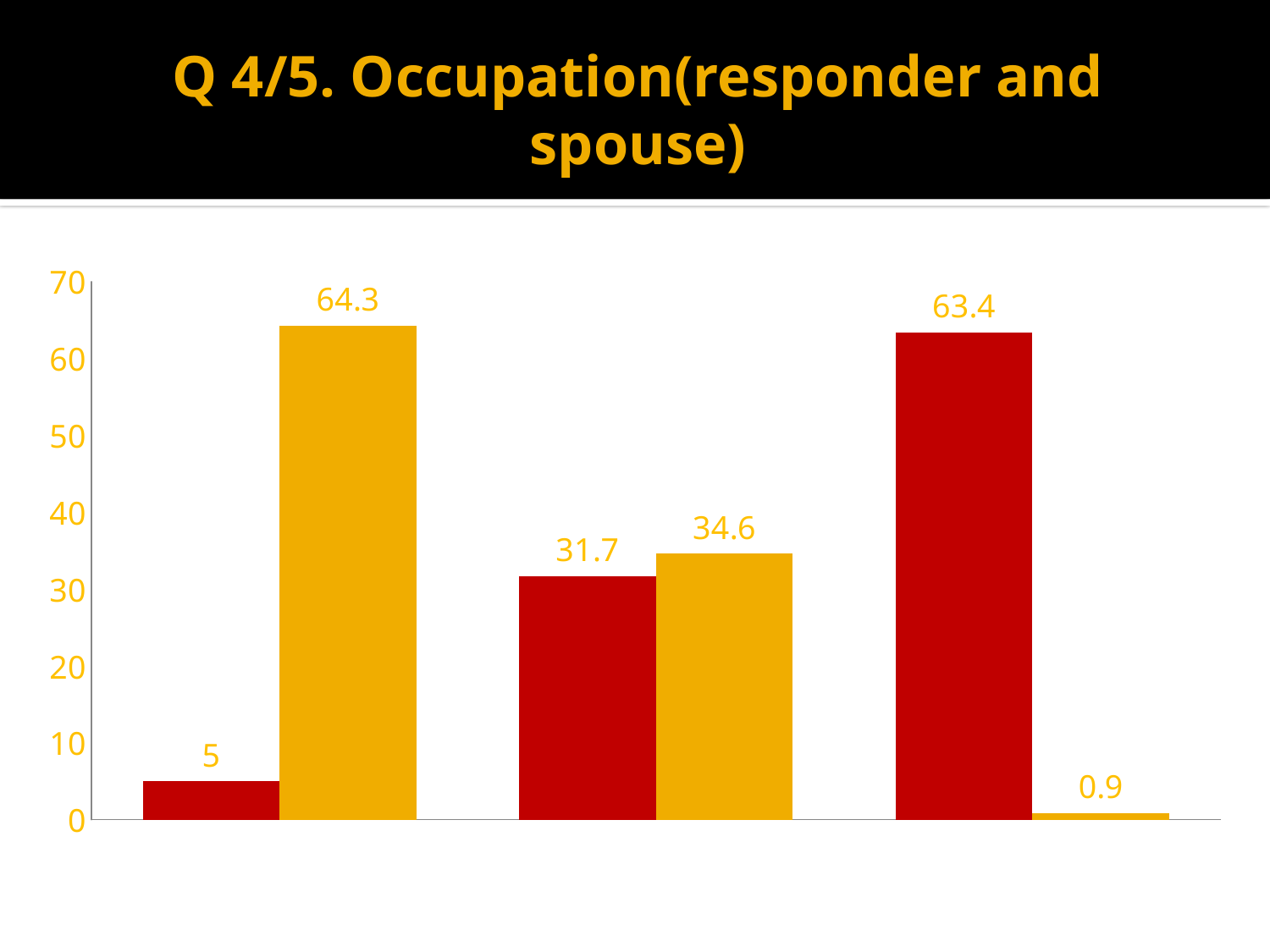
How many groups of bars does the chart contain? 3 In the middle group, which bar is larger, the red one or the yellow one? the yellow one What is the value of the yellow bar in the first (leftmost) group? 64.3 What is the value of the red bar in the first (leftmost) group? 5 What kind of chart is shown on the slide? bar chart What is the lowest value shown on the chart? 0.9 What is the highest value shown on the chart? 64.3 What is the value of the red bar in the middle group? 31.7 What is the title of the slide? Q 4/5. Occupation(responder and spouse) What is the value of the yellow bar in the third (rightmost) group? 0.9 In the middle group, what is the difference between the yellow bar (34.6) and the red bar (31.7)? 2.9 How many bars are plotted in total on the chart? 6